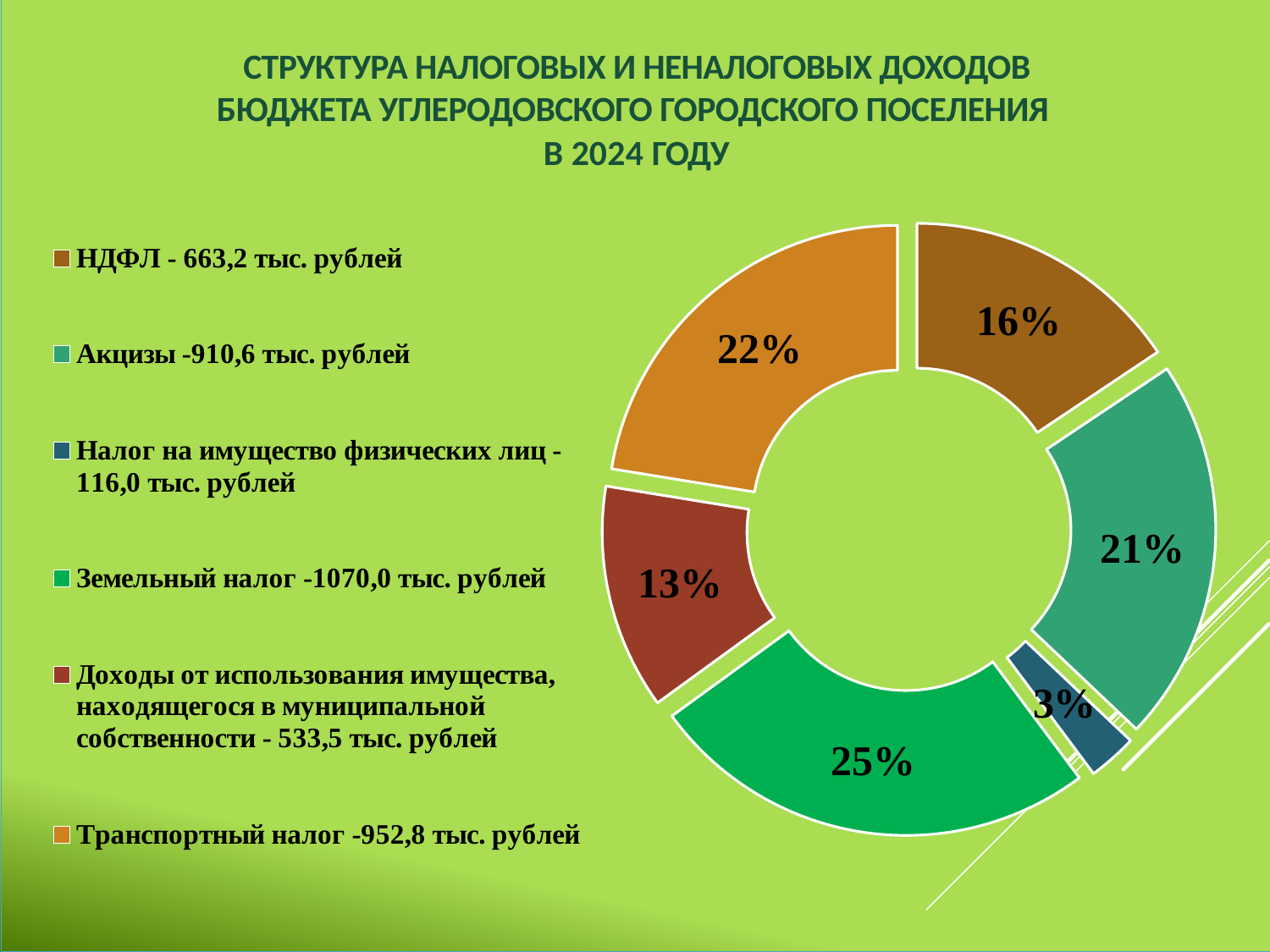
What percentage is shown for the Акцизы slice? 21% What share of the chart does Земельный налог account for? 25% What percentage is shown for the Транспортный налог slice? 22% According to the legend, what is the amount for Налог на имущество физических лиц? 116,0 тыс. рублей According to the legend, what is the amount for Земельный налог? 1070,0 тыс. рублей What is the difference in percentage points between the Земельный налог share and the Доходы от использования имущества share? 12 How many slices does the chart have? 6 What percentage is shown for the НДФЛ slice? 16% Which category has the largest share of the chart? Земельный налог Which share is larger: Транспортный налог or Акцизы? Транспортный налог What kind of chart is shown on the slide? Doughnut (pie) chart Which category has the smallest share of the chart? Налог на имущество физических лиц